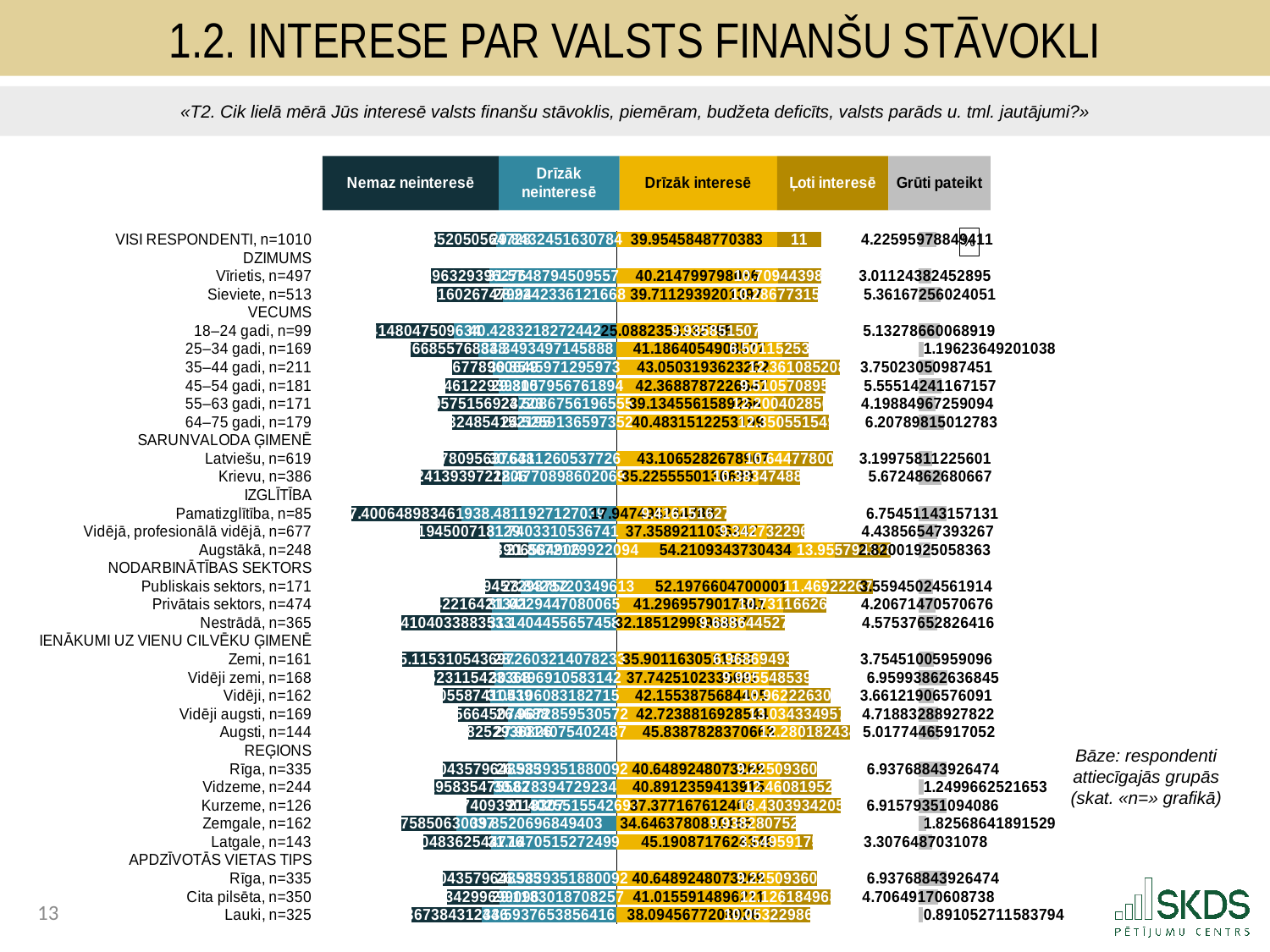
Among the IZGLĪTĪBA groups, which has the highest 'Drīzāk interesē' value? Augstākā, n=248 Among the IZGLĪTĪBA groups, which has the lowest 'Drīzāk interesē' value? Pamatizglītība, n=85 What colour is used for the 'Drīzāk interesē' series? Yellow (gold) What is the 'Drīzāk interesē' value for Publiskais sektors, n=171? 52.1976604700001 What is the 'Drīzāk interesē' value for Augstākā, n=248? 54.2109343730434 What is the 'Drīzāk interesē' value for VISI RESPONDENTI, n=1010? 39.9545848770383 Which has the larger 'Drīzāk interesē' value: Publiskais sektors, n=171 or Privātais sektors, n=474? Publiskais sektors, n=171 What are the legend entries of the chart, from left to right? Nemaz neinteresē, Drīzāk neinteresē, Drīzāk interesē, Ļoti interesē, Grūti pateikt How many regions are listed under REĢIONS in the chart? 5 How many age groups (VECUMS) are plotted in the chart? 6 What kind of chart is shown on the slide? Stacked horizontal bar chart How many series does the legend list? 5